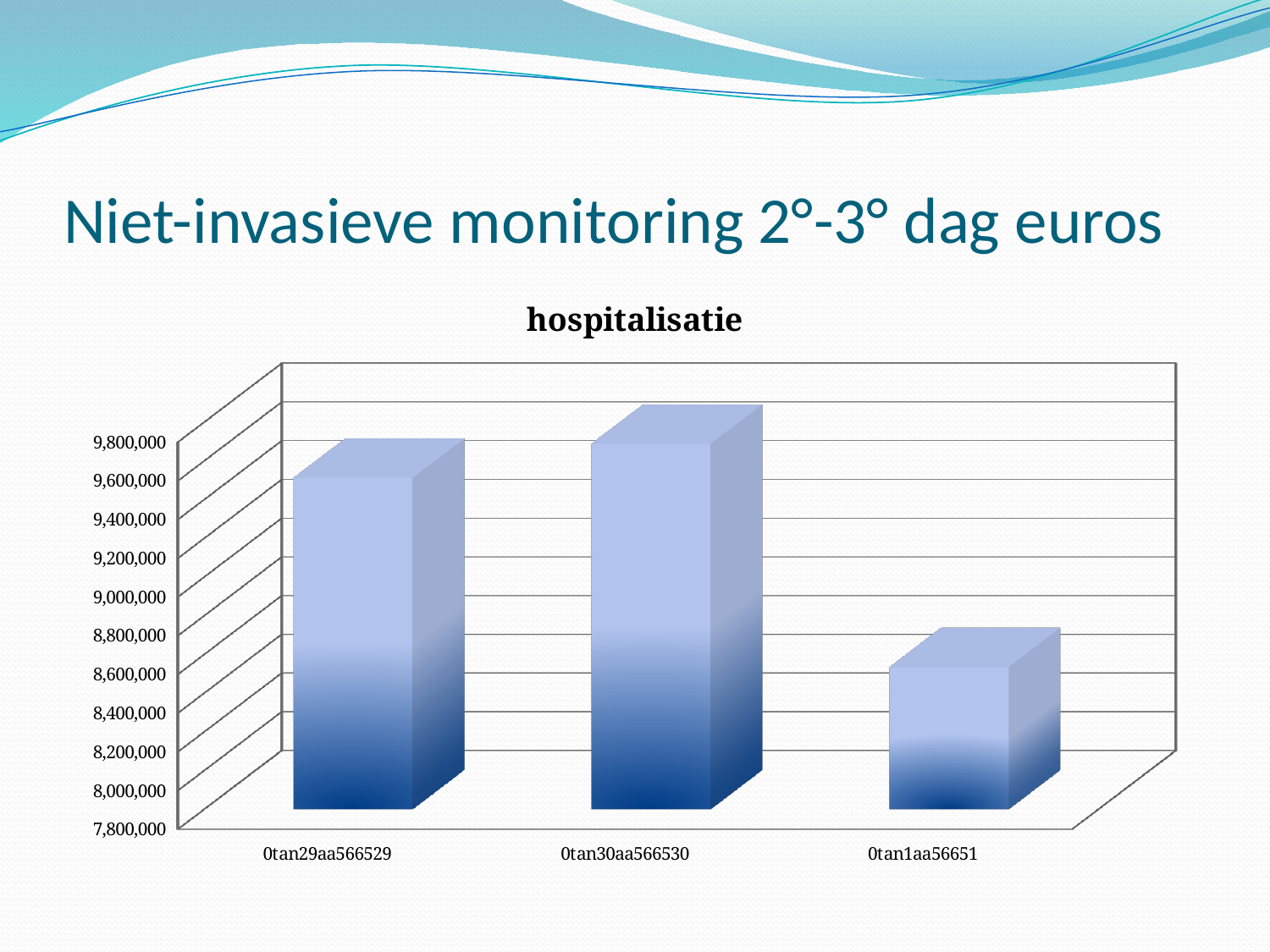
Which is larger, the value for 0tan29aa566529 or the value for 0tan30aa566530? 0tan30aa566530 Is the value for 0tan30aa566530 greater or less than 9,400,000? greater Is the value for 0tan1aa56651 greater or less than 8,200,000? greater What is the lowest value shown on the vertical axis? 7,800,000 Which category has the highest value? 0tan30aa566530 Which is larger, the value for 0tan29aa566529 or the value for 0tan1aa56651? 0tan29aa566529 How many categories are plotted in the chart? 3 Is the value for 0tan1aa56651 greater or less than 9,000,000? less What kind of chart is shown on the slide? bar chart Which category has the lowest value? 0tan1aa56651 What is the title of the chart? hospitalisatie